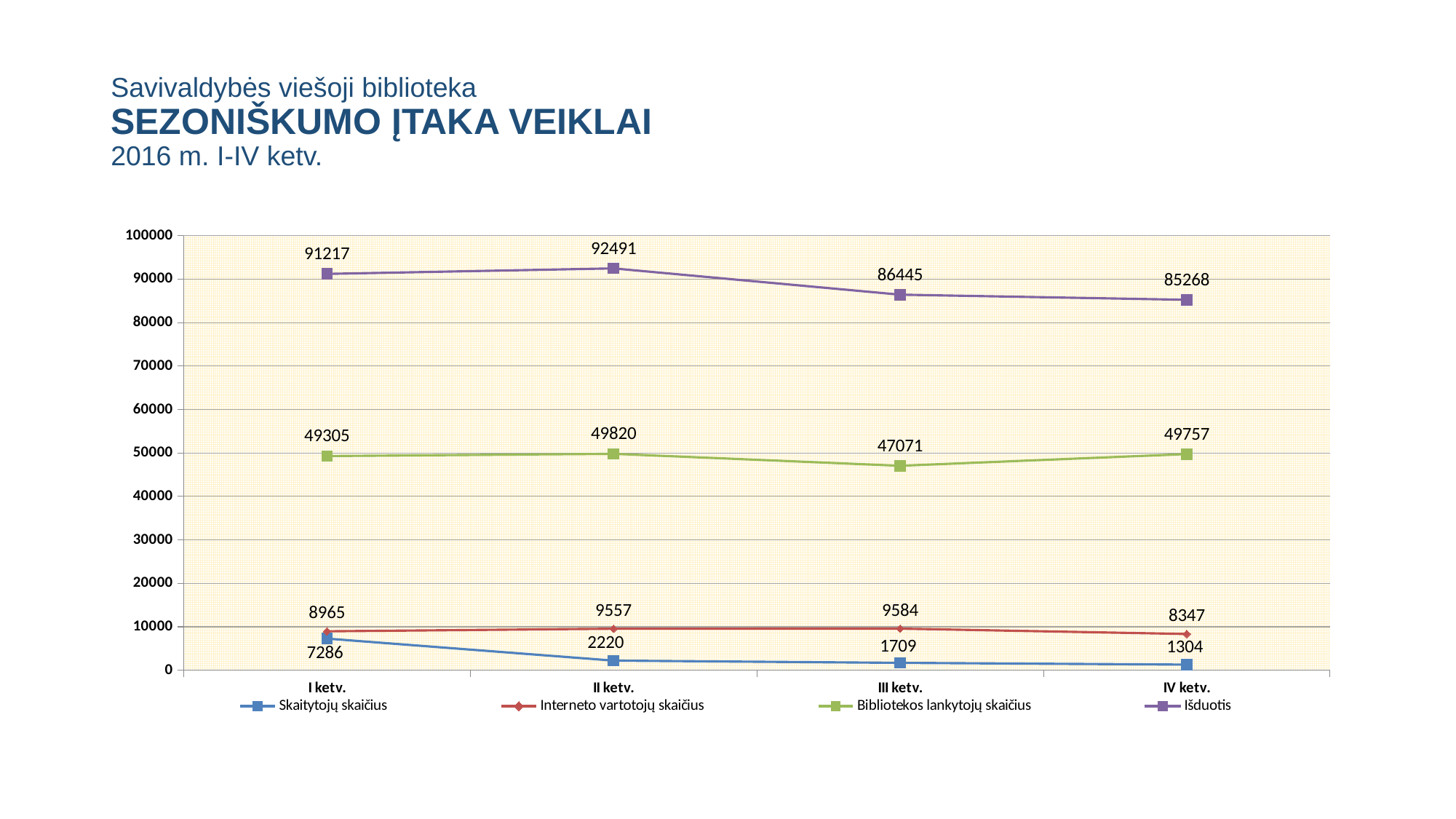
What is the value of Išduotis in II ketv.? 92491 In which quarter is Išduotis highest? II ketv. Which is larger: Interneto vartotojų skaičius in II ketv. or Skaitytojų skaičius in II ketv.? Interneto vartotojų skaičius What is the difference between Išduotis in I ketv. and IV ketv.? 5949 Does Skaitytojų skaičius rise or fall from I ketv. to IV ketv.? fall What type of chart is shown on the slide? line chart In which quarter is Skaitytojų skaičius lowest? IV ketv. How many quarters (categories) are plotted on the x axis? 4 How many series does the legend list? 4 Is the value of Bibliotekos lankytojų skaičius in II ketv. greater or less than 40000? greater What is the value of Bibliotekos lankytojų skaičius in III ketv.? 47071 What is the value of Skaitytojų skaičius in IV ketv.? 1304